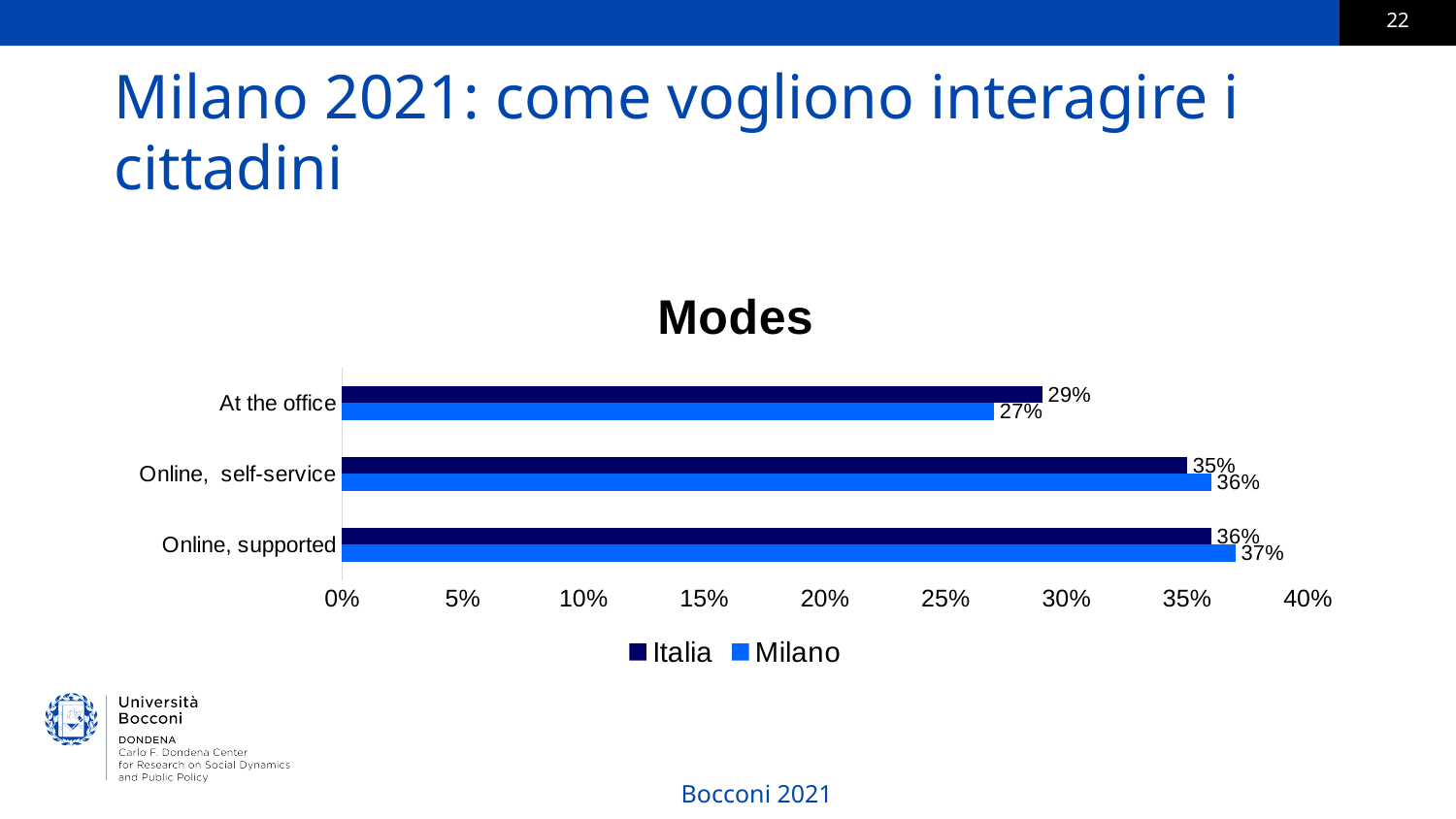
How many categories are shown on the chart? 3 What is the value for Milano for 'At the office'? 27% What kind of chart is shown on the slide? Bar chart Which category has the lowest value for Italia? At the office What is the difference between the Italia and Milano values for 'At the office'? 2% For 'Online, self-service', which is larger: the Italia value or the Milano value? Milano What is the value for Italia for 'Online, supported'? 36% What is the title of the chart? Modes How many series does the legend list? 2 Which category has the highest value for Milano? Online, supported What is the value for Italia for 'At the office'? 29% What is the value for Milano for 'Online, self-service'? 36%